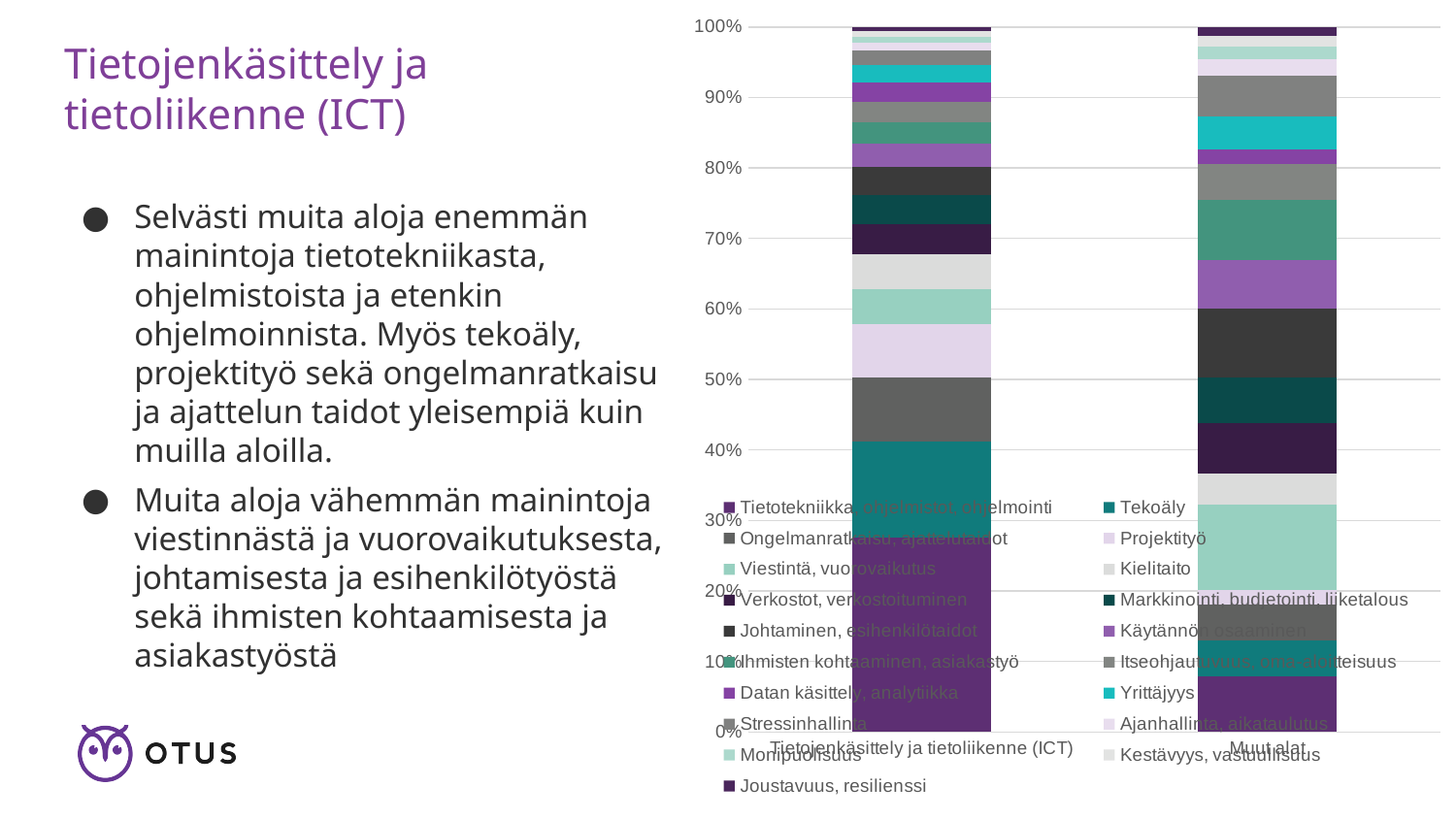
Which bar has the larger 'Viestintä, vuorovaikutus' segment, 'Tietojenkäsittely ja tietoliikenne (ICT)' or 'Muut alat'? Muut alat Which bar has the larger 'Tekoäly' segment, 'Tietojenkäsittely ja tietoliikenne (ICT)' or 'Muut alat'? Tietojenkäsittely ja tietoliikenne (ICT) Which bar has the larger 'Johtaminen, esihenkilötaidot' segment, 'Tietojenkäsittely ja tietoliikenne (ICT)' or 'Muut alat'? Muut alat How many series does the chart's legend list? 19 What are the two categories on the x axis of the chart? Tietojenkäsittely ja tietoliikenne (ICT) and Muut alat What kind of chart is shown on the slide? stacked bar chart Which series is listed first in the chart's legend? Tietotekniikka, ohjelmistot, ohjelmointi Is the share of 'Tietotekniikka, ohjelmistot, ohjelmointi' in the 'Muut alat' bar greater or less than 10%? less How many categories (bars) are shown on the x axis of the chart? 2